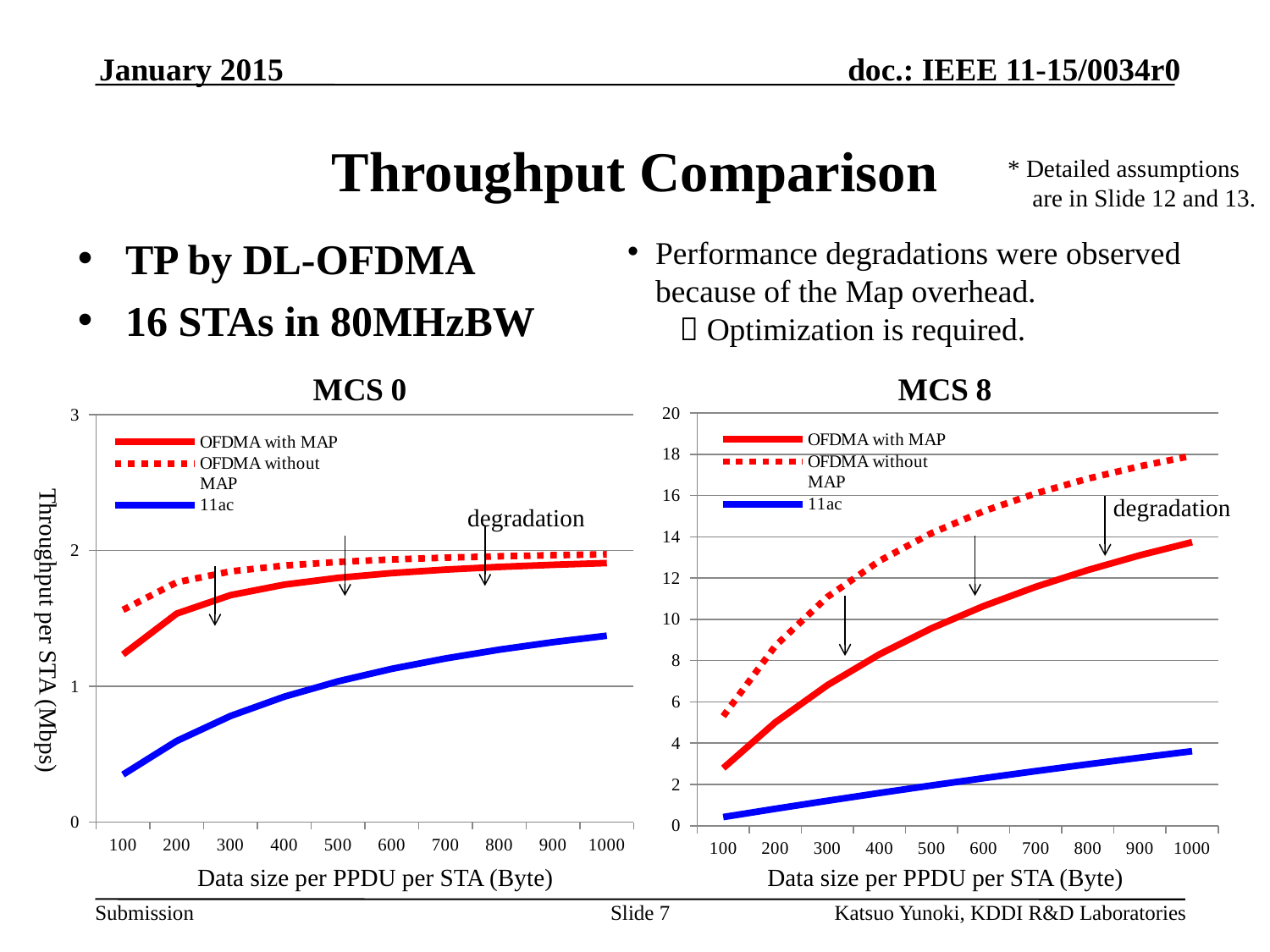
In the MCS 8 chart, is the 11ac value at 1000 bytes greater or less than 4? less In the MCS 0 chart, is the OFDMA with MAP value at 100 bytes greater or less than 1? greater In the MCS 8 chart, does the 11ac throughput rise or fall as data size per PPDU per STA increases? rise In the MCS 8 chart, which is larger at 1000 bytes: OFDMA with MAP or 11ac? OFDMA with MAP In the MCS 0 chart, is the 11ac value at 100 bytes greater or less than 1? less How many data size values are marked along the x axis of the MCS 0 chart? 10 In the MCS 0 chart, which series has the lowest throughput across the data sizes? 11ac What kind of chart is the MCS 0 chart? line chart How many series does the legend of the MCS 8 chart list? 3 What is the y-axis label of the MCS 0 chart? Throughput per STA (Mbps)